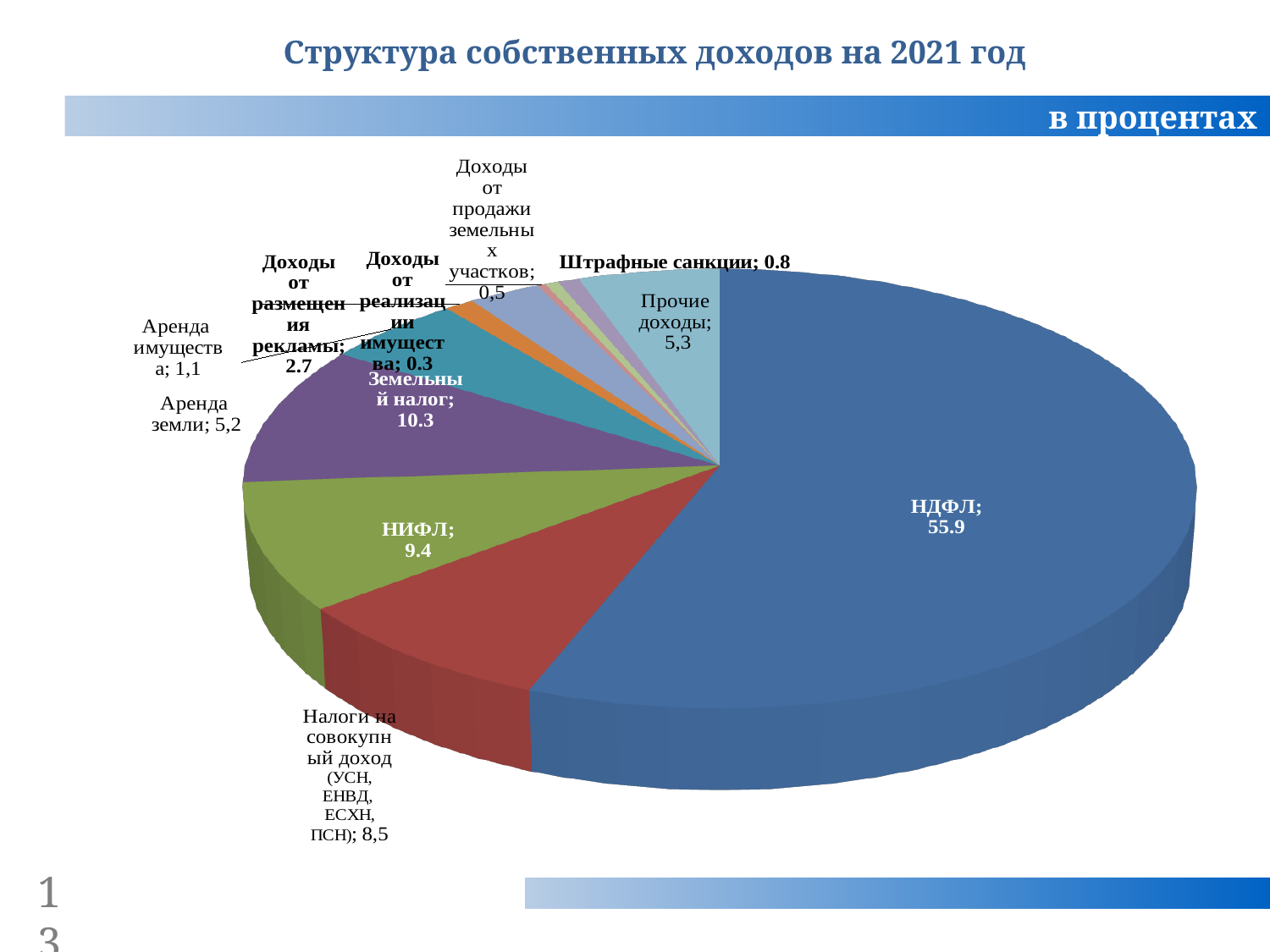
What is the difference between the values for НДФЛ and Земельный налог? 45.6 Which category has the largest share of the pie? НДФЛ What is the value for Земельный налог? 10.3 What is the title of the chart on the slide? Структура собственных доходов на 2021 год What share of the pie does Прочие доходы represent? 5,3 Which is larger, the value for НИФЛ or the value for Аренда земли? НИФЛ Which category has the smallest share of the pie? Доходы от реализации имущества What is the value for Налоги на совокупный доход (УСН, ЕНВД, ЕСХН, ПСН)? 8,5 What is the value for Штрафные санкции? 0.8 What is the value for НДФЛ? 55.9 How many categories (slices) does the pie chart have? 11 What type of chart is shown on the slide? Pie chart